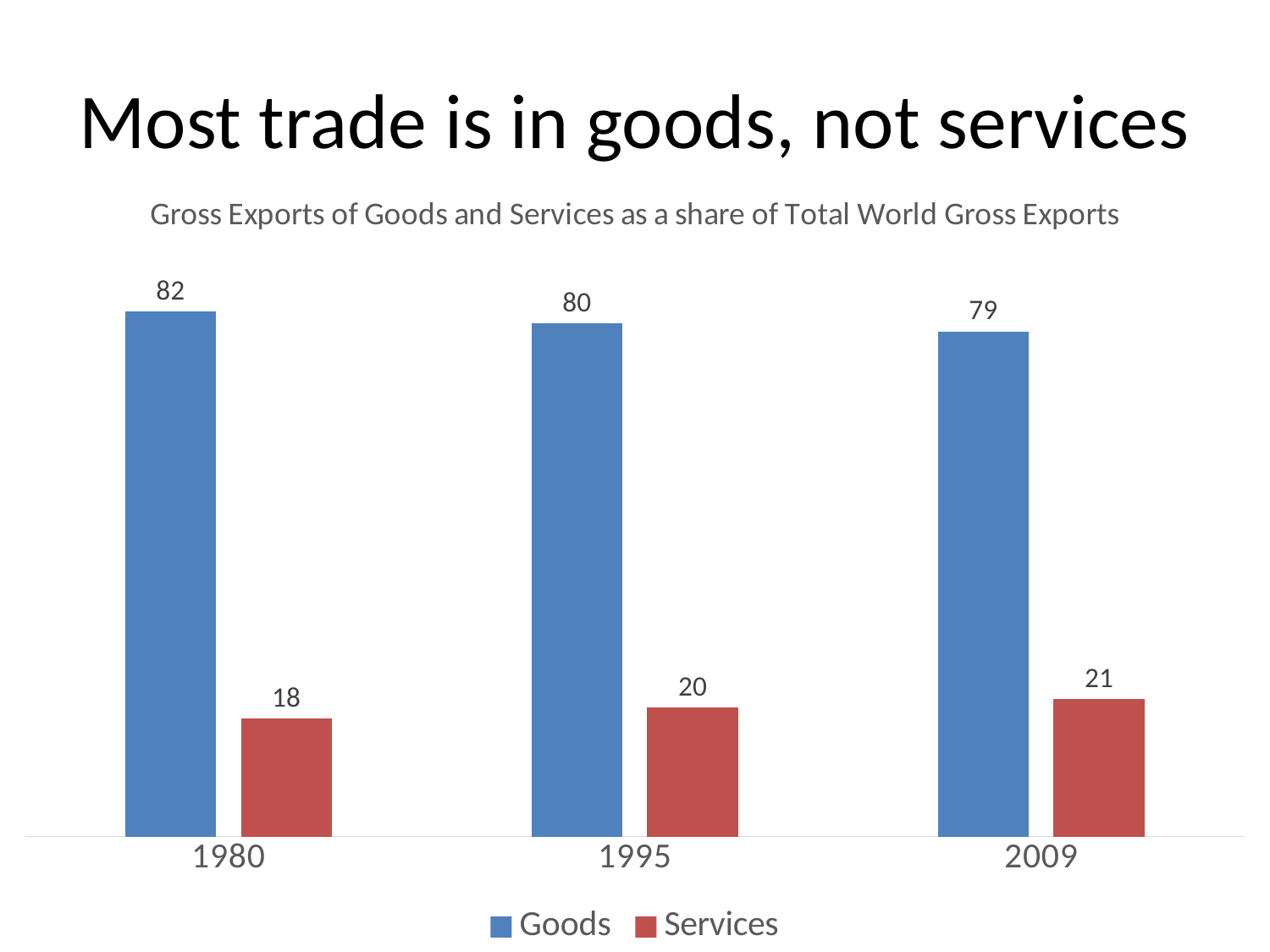
Does the Services value rise or fall from 1980 to 2009? Rise How many series does the legend list? 2 What kind of chart is shown on the slide? Bar chart What is the value for Goods in 1980? 82 What is the difference between the Goods and Services values in 2009? 58 What is the value for Services in 1995? 20 Which is larger in 1995, Goods or Services? Goods What colour are the Services bars? Red What is the value for Services in 2009? 21 How many years are shown on the x axis? 3 In which year is the Services value lowest? 1980 In which year is the Goods value highest? 1980